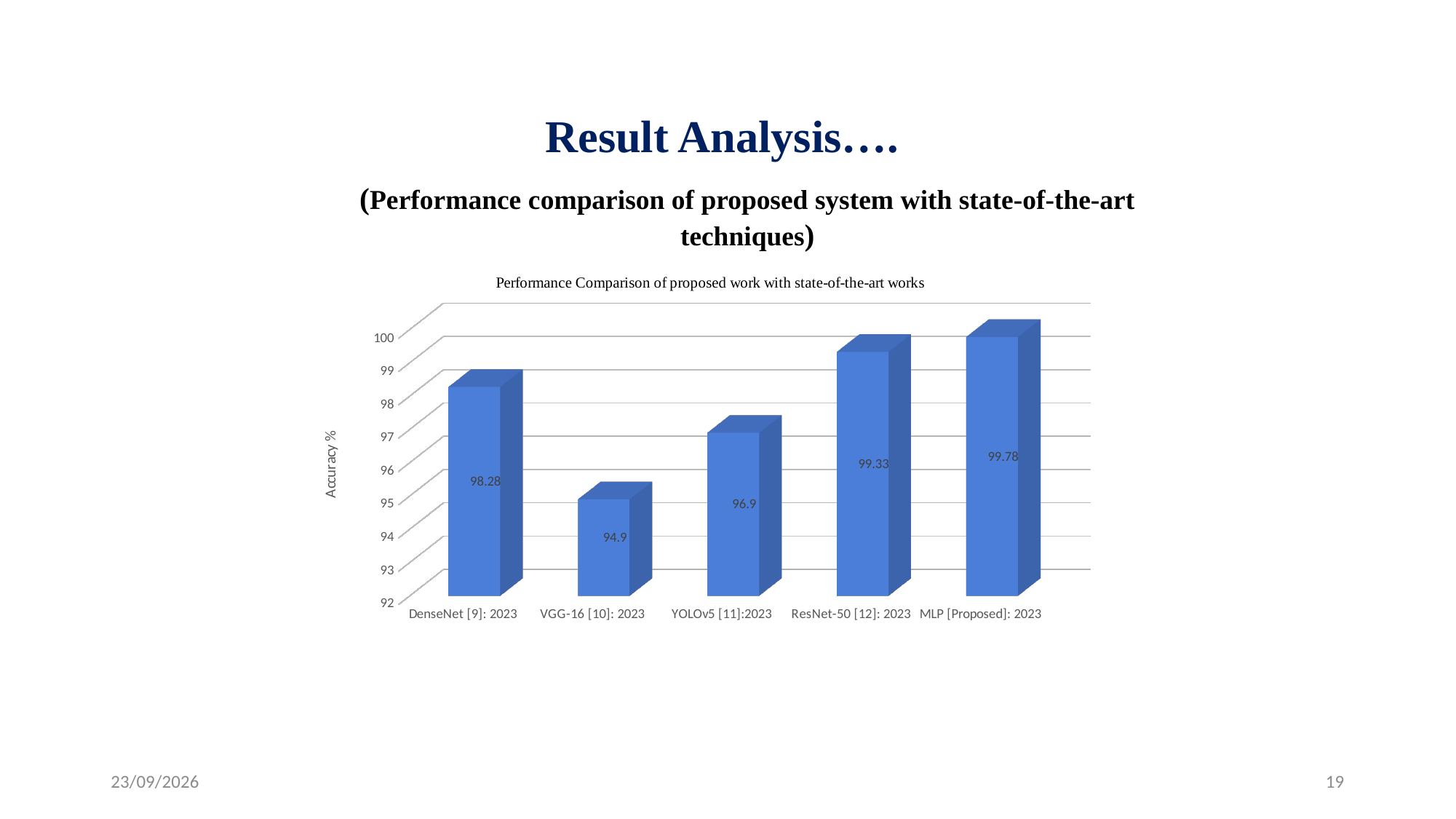
What is the accuracy value for MLP [Proposed]: 2023? 99.78 Which technique has the highest accuracy? MLP [Proposed]: 2023 What is the accuracy value for YOLOv5 [11]:2023? 96.9 How many techniques are compared in the chart? 5 Which has a higher accuracy, DenseNet [9]: 2023 or YOLOv5 [11]:2023? DenseNet [9]: 2023 What is the label of the vertical axis of the chart? Accuracy % What is the difference in accuracy between MLP [Proposed]: 2023 and ResNet-50 [12]: 2023? 0.45 What is the accuracy value for DenseNet [9]: 2023? 98.28 Which technique has the lowest accuracy? VGG-16 [10]: 2023 What type of chart is shown on the slide? Bar chart What is the difference in accuracy between DenseNet [9]: 2023 and VGG-16 [10]: 2023? 3.38 What is the accuracy value for VGG-16 [10]: 2023? 94.9